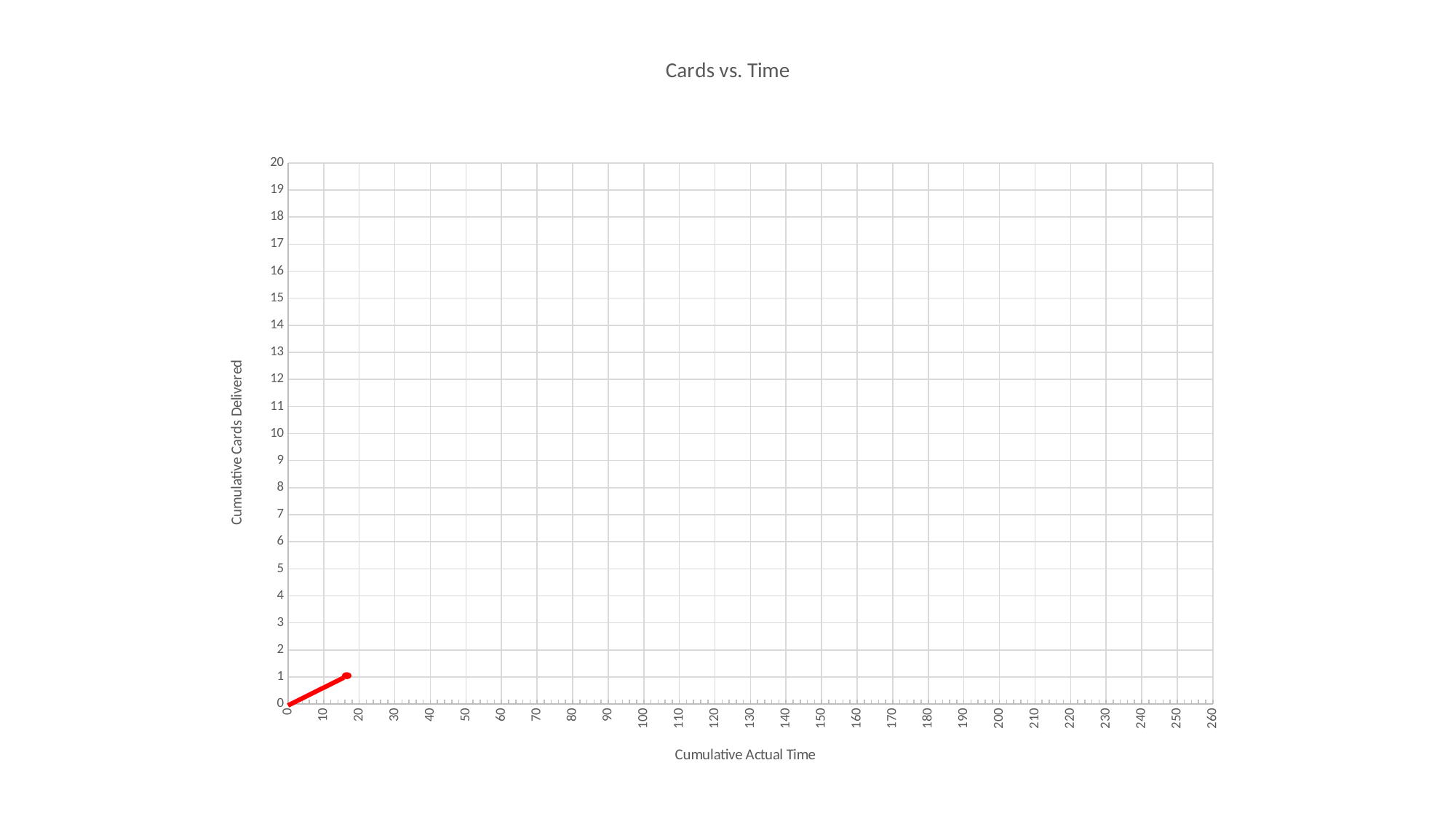
Is the Cumulative Cards Delivered value at the end of the line greater or less than 5? less What colour is the plotted line in the chart? red What is the highest Cumulative Cards Delivered value reached by the plotted line? 1 What type of chart is shown on the slide? line chart Is the Cumulative Actual Time at the end of the line greater or less than 10? greater What is the lowest Cumulative Cards Delivered value on the plotted line? 0 Does the plotted line rise or fall as Cumulative Actual Time increases? rises What is the title of the chart? Cards vs. Time Is the Cumulative Actual Time at the end of the line greater or less than 50? less How many data points are plotted on the chart? 2